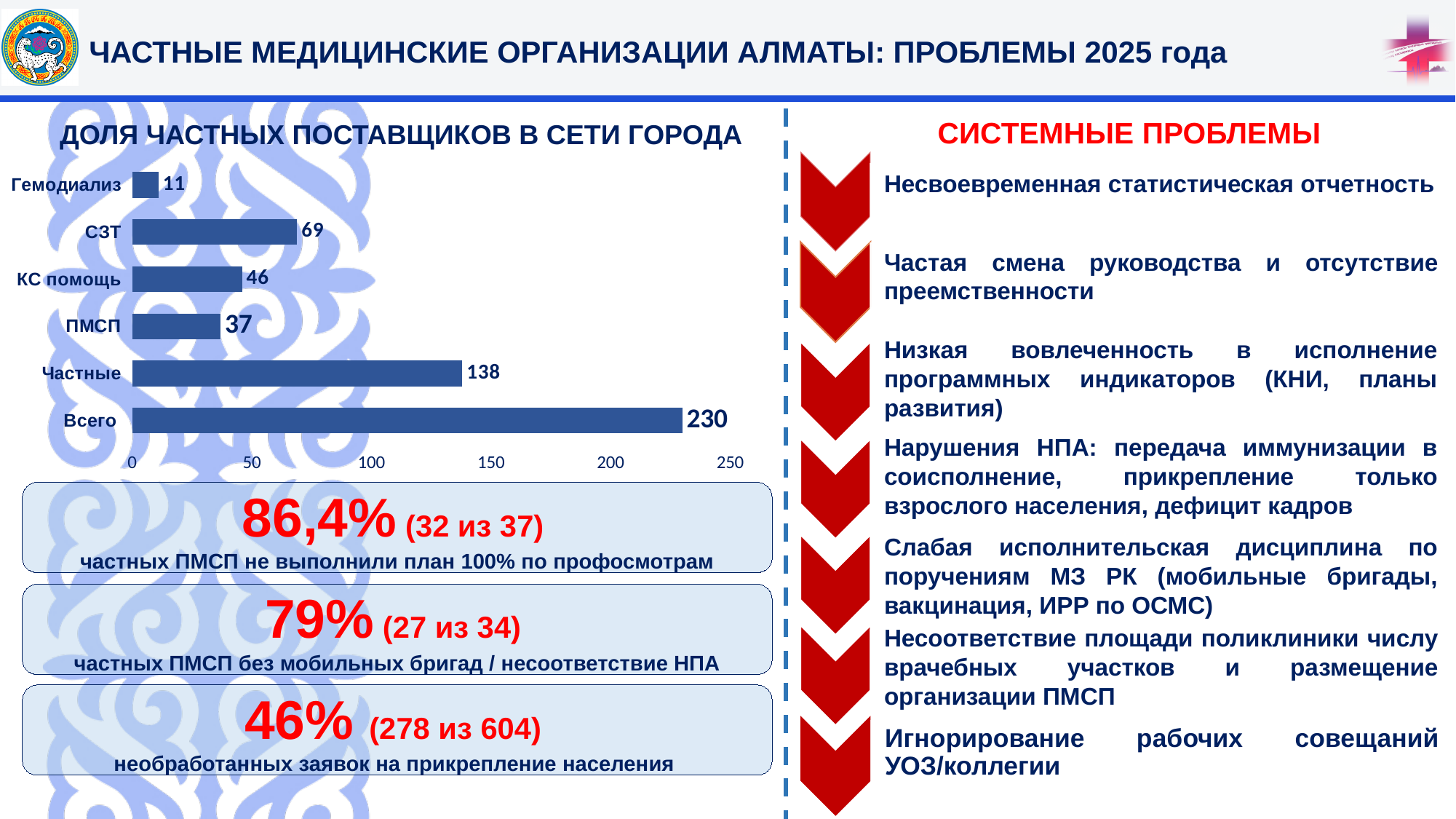
What is the value for КС помощь in the chart? 46 Which category has the lowest value in the chart? Гемодиализ What type of chart is shown on the slide? bar chart What is the difference between the values for СЗТ and ПМСП? 32 What is the title of the bar chart? ДОЛЯ ЧАСТНЫХ ПОСТАВЩИКОВ В СЕТИ ГОРОДА What is the value for Частные in the chart? 138 What is the value for Всего in the chart? 230 What is the difference between the values for Всего and Частные? 92 Which is larger, the value for СЗТ or the value for КС помощь? СЗТ What is the value for Гемодиализ in the chart? 11 How many categories are shown in the bar chart? 6 Which category has the highest value in the chart? Всего